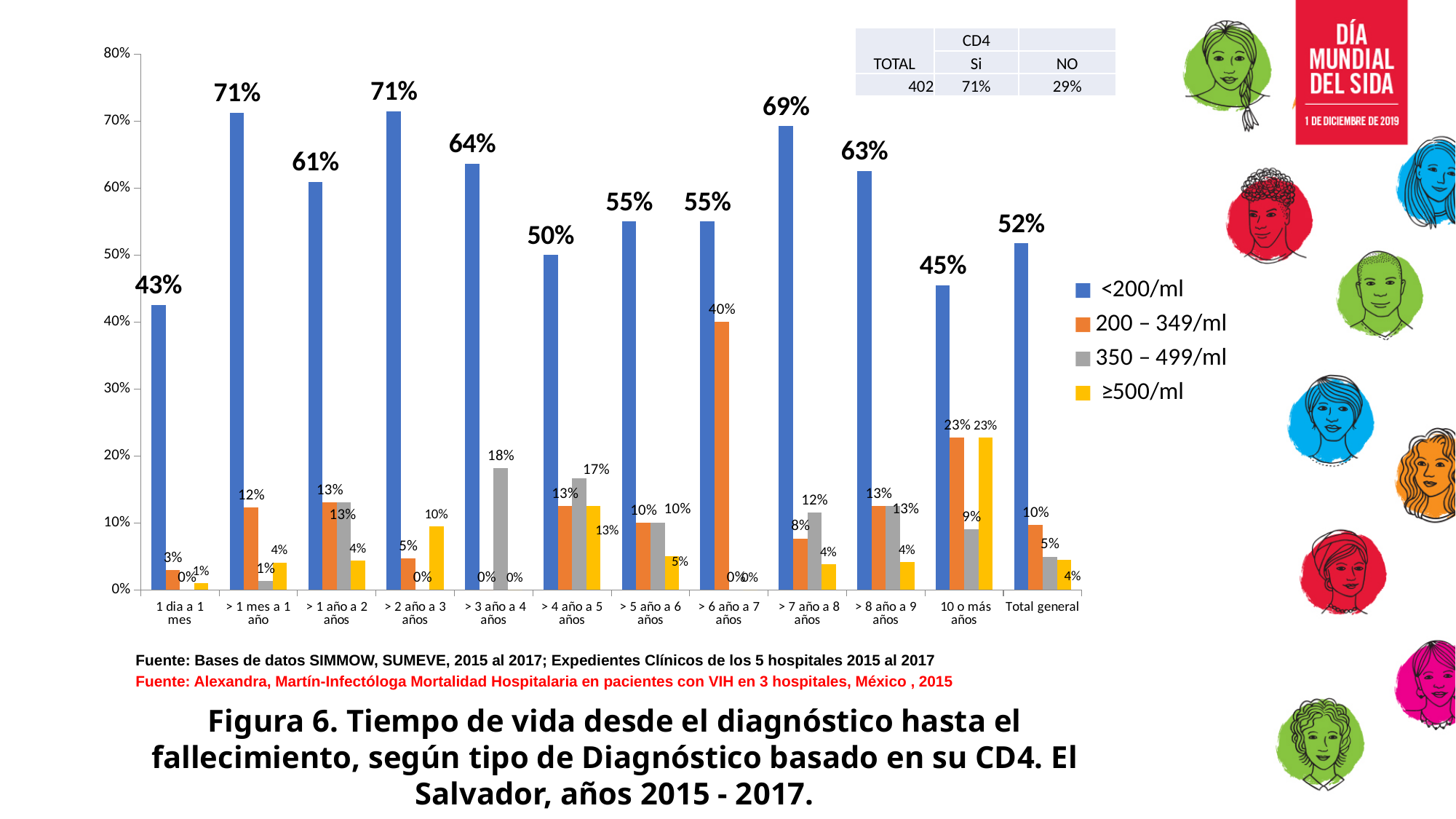
How many categories are shown on the x axis of the chart? 12 What is the difference between the <200/ml values for "> 7 año a 8 años" and "> 8 año a 9 años"? 6% Which category has the highest value in the 350 – 499/ml series? > 3 año a 4 años What colour represents the ≥500/ml series in the legend? Yellow How many series does the legend list? 4 What is the value of the <200/ml series for the category "1 dia a 1 mes"? 43% Which has the larger <200/ml value: "> 1 año a 2 años" or "> 3 año a 4 años"? > 3 año a 4 años What is the value of the 200 – 349/ml series for the category "> 6 año a 7 años"? 40% What is the value of the <200/ml series for "Total general"? 52% What is the value of the ≥500/ml series for the category "10 o más años"? 23% Which category has the lowest value in the <200/ml series? 1 dia a 1 mes What kind of chart is shown on the slide? Bar chart